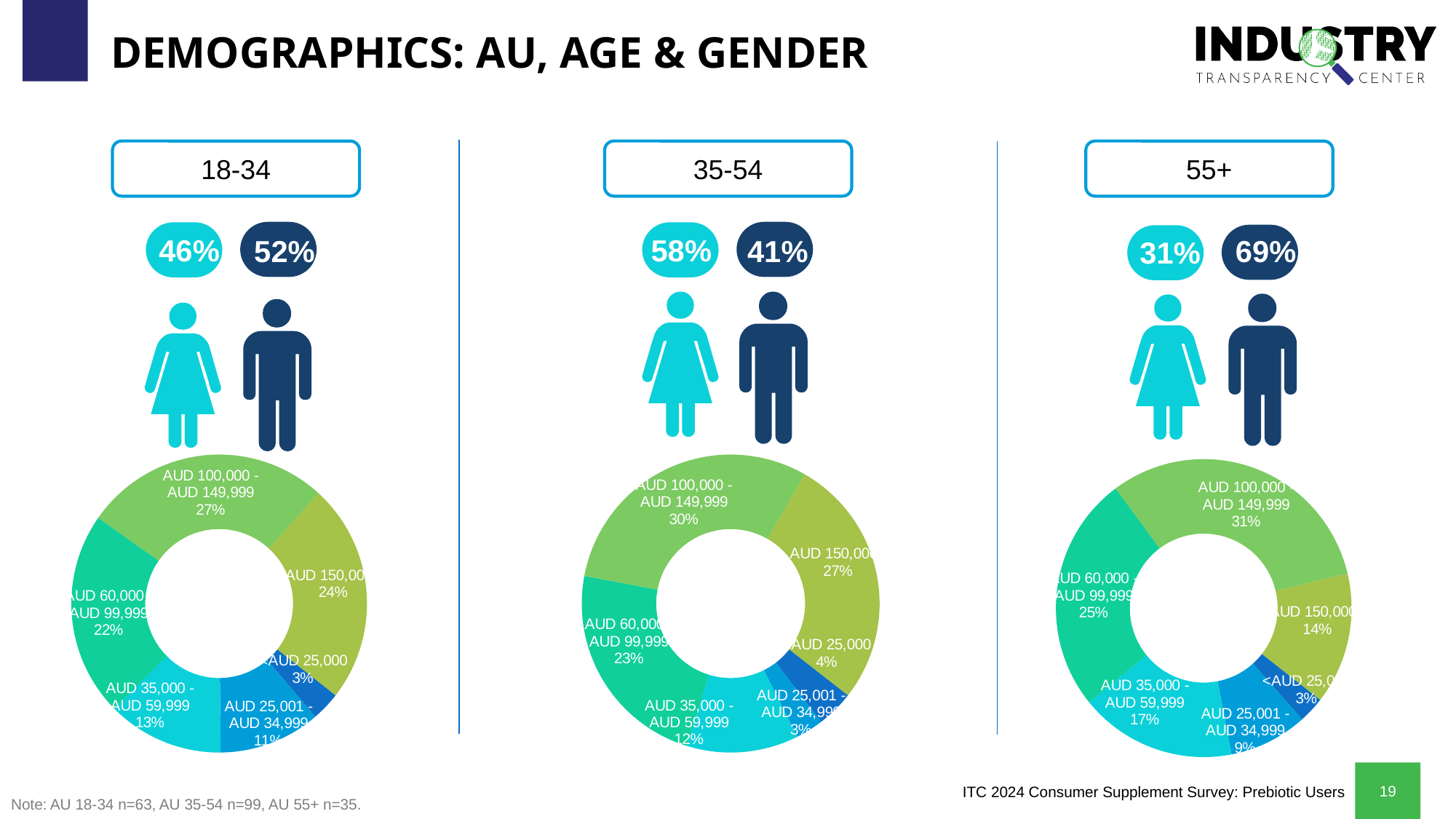
In the 18-34 donut chart, what is the difference between the AUD 100,000 - AUD 149,999 share and the AUD 150,000+ share? 3% In the 55+ donut chart, which is larger: AUD 60,000 - AUD 99,999 or AUD 150,000+? AUD 60,000 - AUD 99,999 What is the male percentage shown for the 55+ age group? 69% In the 35-54 donut chart, which income bracket has the smallest share? AUD 25,001 - AUD 34,999 In the 55+ donut chart, which income bracket has the largest share? AUD 100,000 - AUD 149,999 In the 55+ donut chart, what share is AUD 35,000 - AUD 59,999? 17% In the 18-34 donut chart, which income bracket has the smallest share? <AUD 25,000 What type of chart is used to show income brackets for each age group? Donut chart How many income brackets does the 35-54 donut chart show? 6 In the 35-54 donut chart, what share is AUD 60,000 - AUD 99,999? 23% How many donut charts are on the slide? 3 In the 18-34 donut chart, what share is AUD 100,000 - AUD 149,999? 27%